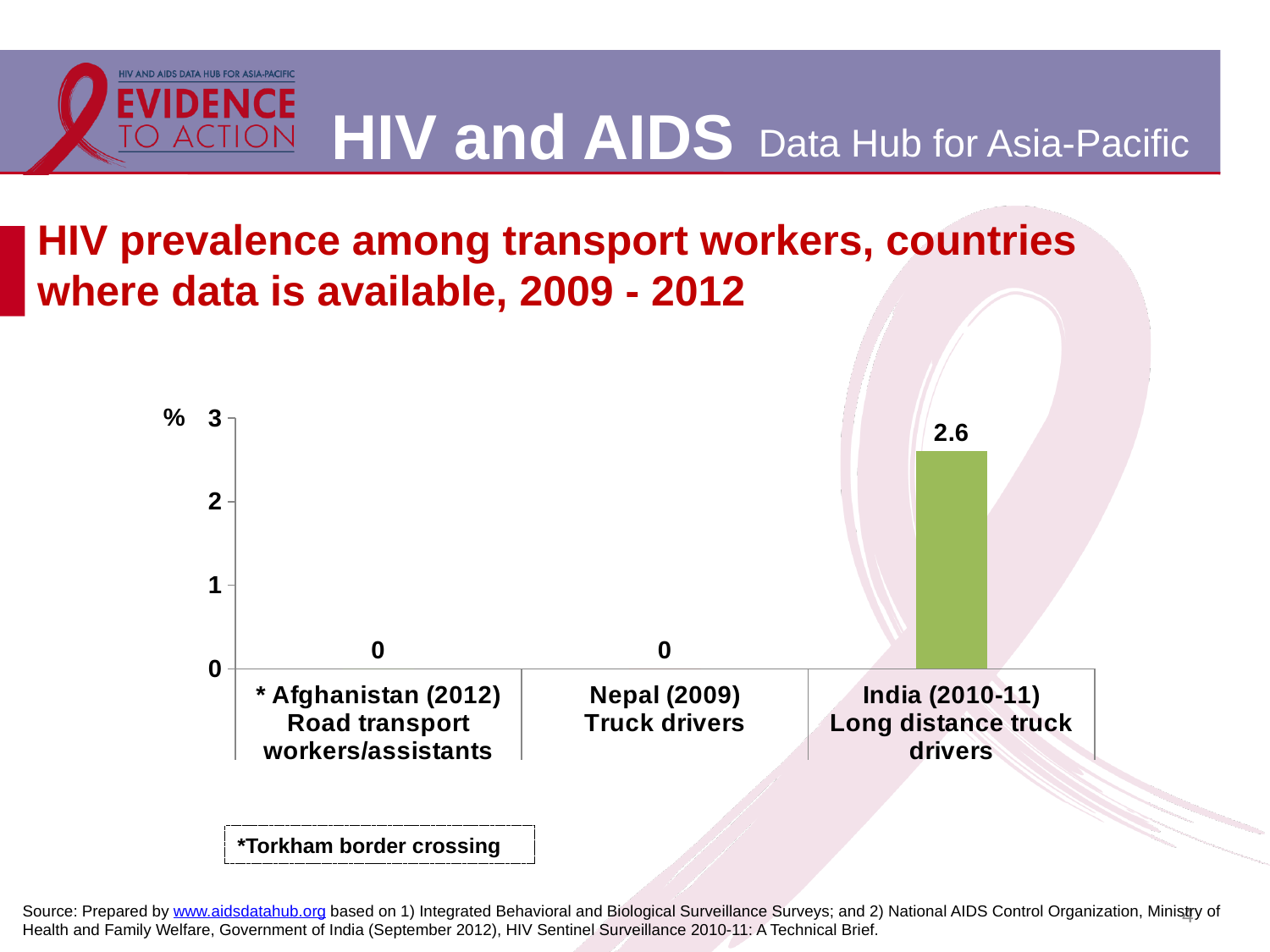
What kind of chart is shown on the slide? Bar chart What is the HIV prevalence value shown for India (2010-11) Long distance truck drivers? 2.6 What is the value shown for Nepal (2009) Truck drivers? 0 What is the maximum value shown on the y axis of the chart? 3 Which is larger, the value for India (2010-11) or the value for Afghanistan (2012)? India (2010-11) Is the value for India (2010-11) Long distance truck drivers greater or less than 2? greater What is the value shown for Afghanistan (2012) Road transport workers/assistants? 0 Which category has the highest HIV prevalence on the chart? India (2010-11) Long distance truck drivers What is the difference between the value for India (2010-11) and the value for Nepal (2009)? 2.6 What unit is indicated on the y axis of the chart? % How many categories are shown on the x axis of the chart? 3